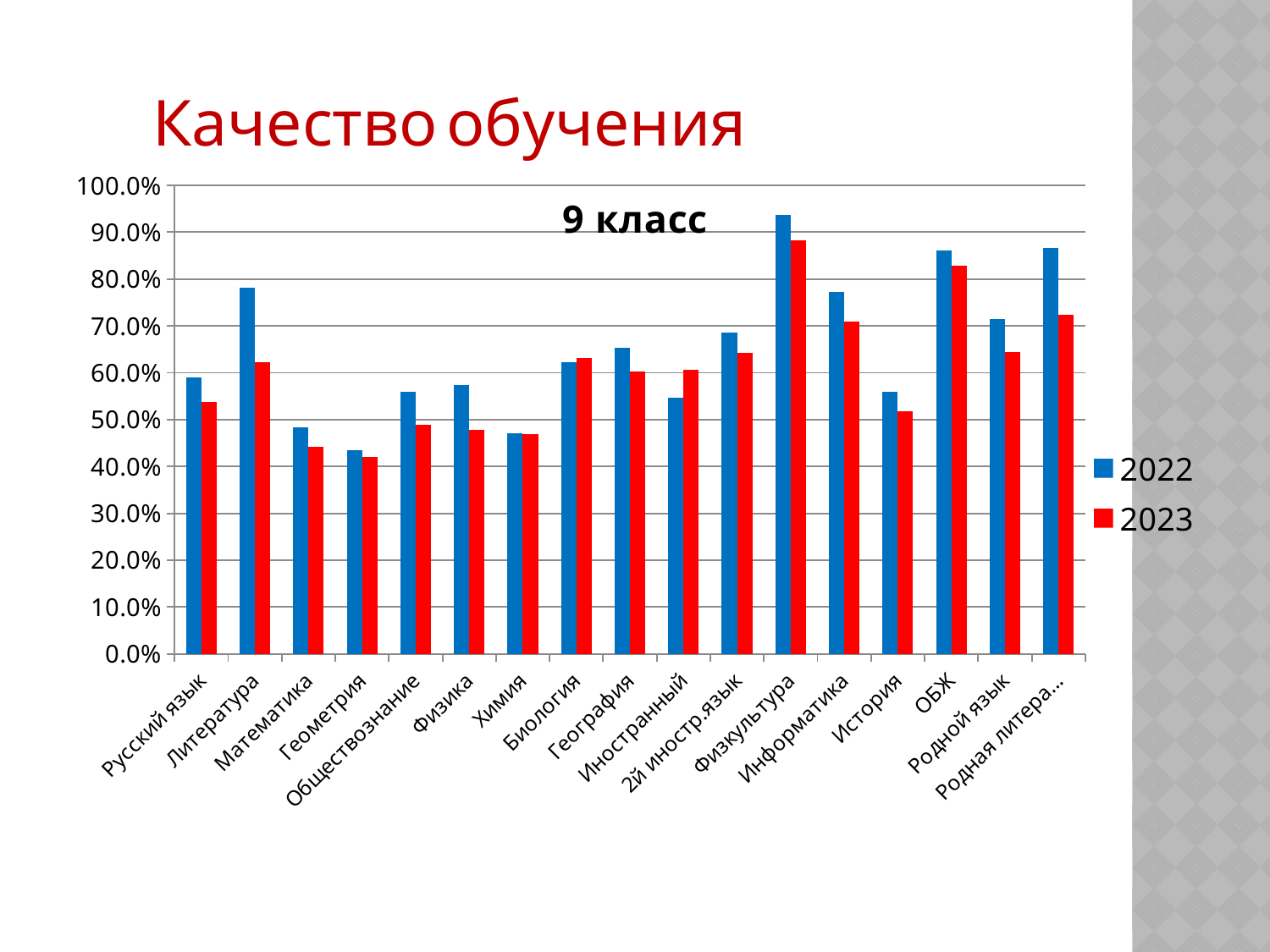
What kind of chart is shown on the slide? bar chart Which subject has the lowest value for 2023? Геометрия Is the 2022 value for Химия greater or less than 50.0%? less Is the 2023 value for Математика greater or less than 50.0%? less Is the 2022 value for ОБЖ greater or less than 80.0%? greater How many series does the legend list? 2 Which subject has the highest value for 2022? Физкультура Which class is named in the label inside the chart area? 9 класс For Иностранный, which year has the larger value, 2022 or 2023? 2023 How many subject categories are plotted along the x axis? 17 For Литература, which year has the larger value, 2022 or 2023? 2022